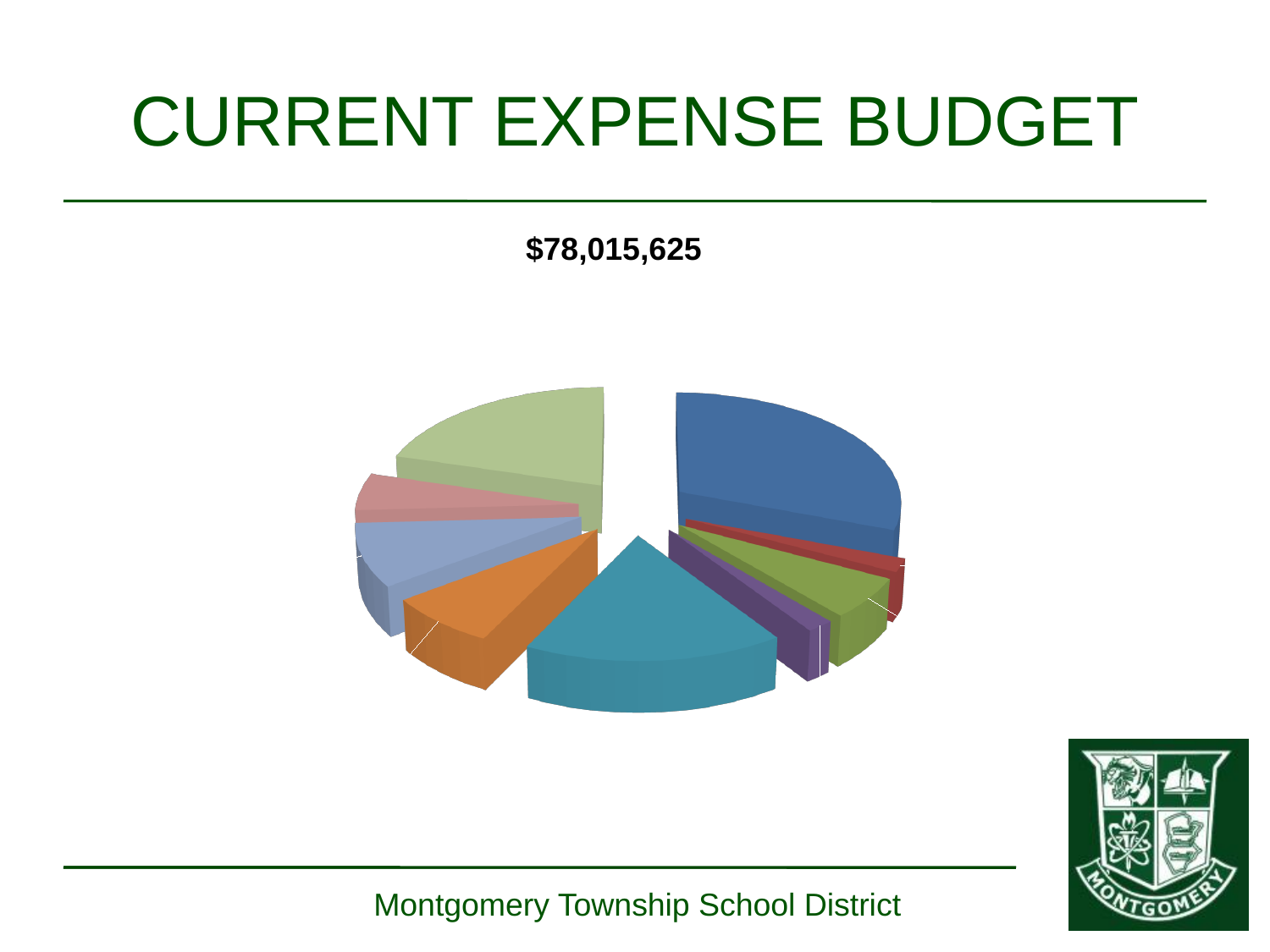
What kind of chart is shown on the slide? pie chart How many slices does the pie chart have? 9 What title is printed directly above the pie chart? $78,015,625 Which slice is larger, the teal slice or the purple slice? teal Does the pie chart include a legend identifying the slices? No Which slice is larger, the blue slice or the orange slice? blue Which colour slice is the largest in the pie chart? blue